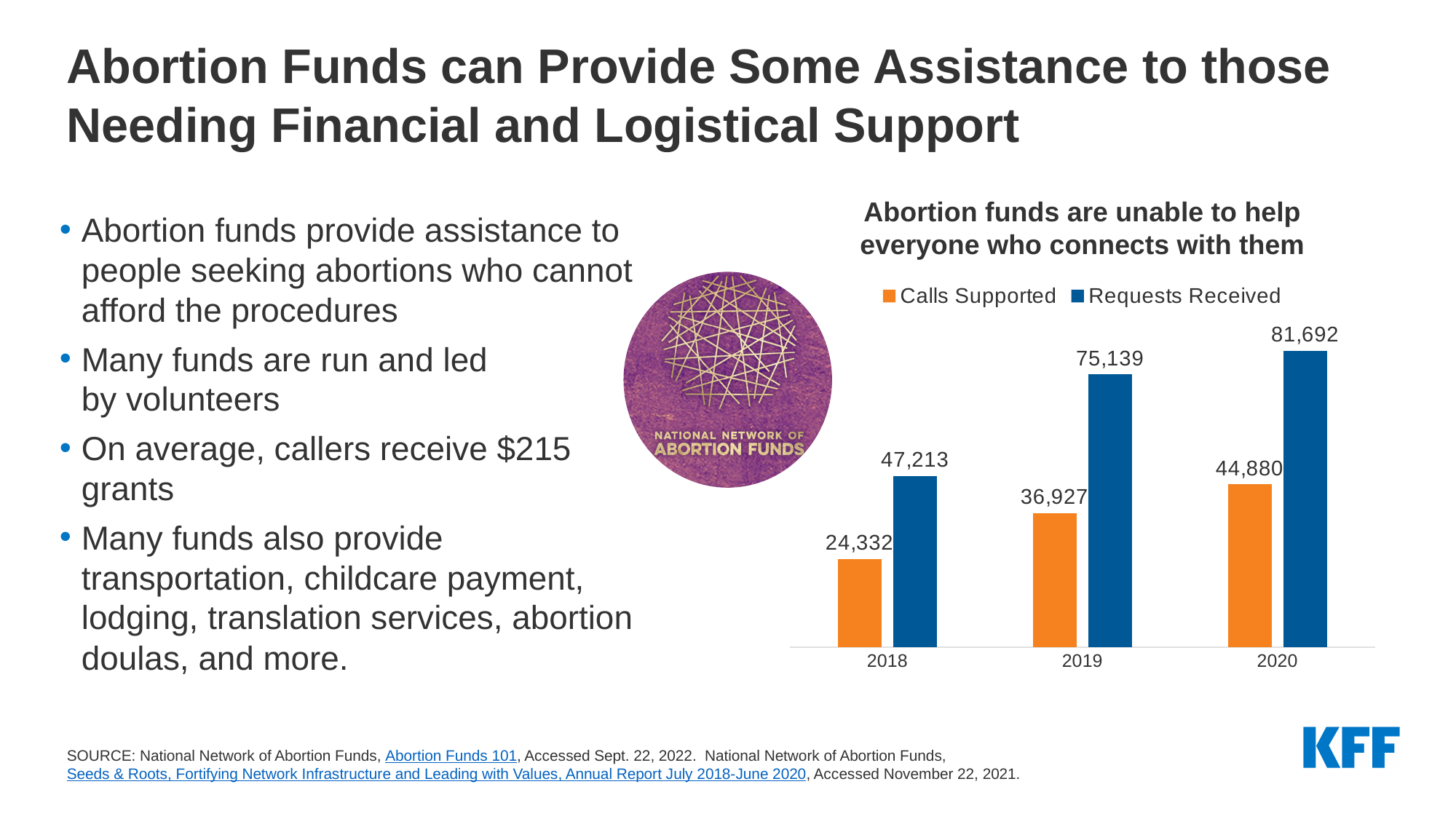
What kind of chart is shown on the slide? Bar chart What is the difference between Calls Supported in 2019 and in 2018? 12,595 What is the difference between Requests Received and Calls Supported in 2020? 36,812 How many series does the chart legend list? 2 In which year were Calls Supported lowest? 2018 What was the number of Requests Received in 2020? 81,692 Which was larger in 2019, Calls Supported or Requests Received? Requests Received In which year were Requests Received highest? 2020 What was the number of Calls Supported in 2018? 24,332 Do Requests Received rise or fall from 2018 to 2020? Rise How many years are shown on the x axis of the chart? 3 What was the number of Requests Received in 2019? 75,139